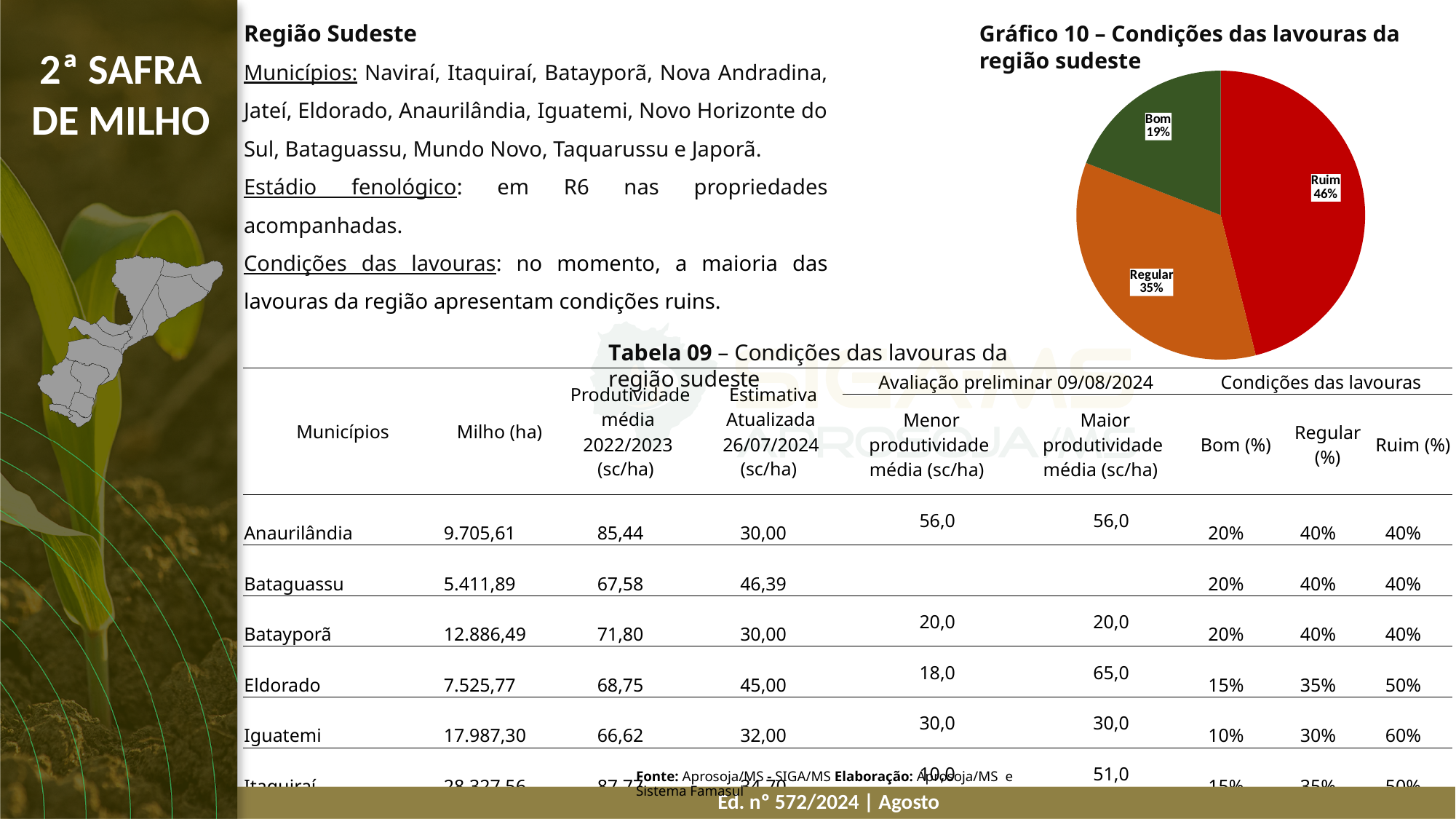
Which category has the largest slice in Gráfico 10? Ruim What share of the pie in Gráfico 10 does Ruim represent? 46% In Gráfico 10, what is the difference between the Ruim and Bom shares? 27% How many slices does the pie in Gráfico 10 have? 3 In Gráfico 10, what is the difference between the Regular and Bom shares? 16% Which category has the smallest slice in Gráfico 10? Bom What is the value for Regular in Gráfico 10? 35% What kind of chart is Gráfico 10? pie chart What is the value for Ruim in Gráfico 10? 46% What colour is the Ruim slice in Gráfico 10? red What is the value for Bom in Gráfico 10? 19% In Gráfico 10, which is larger, Regular or Bom? Regular